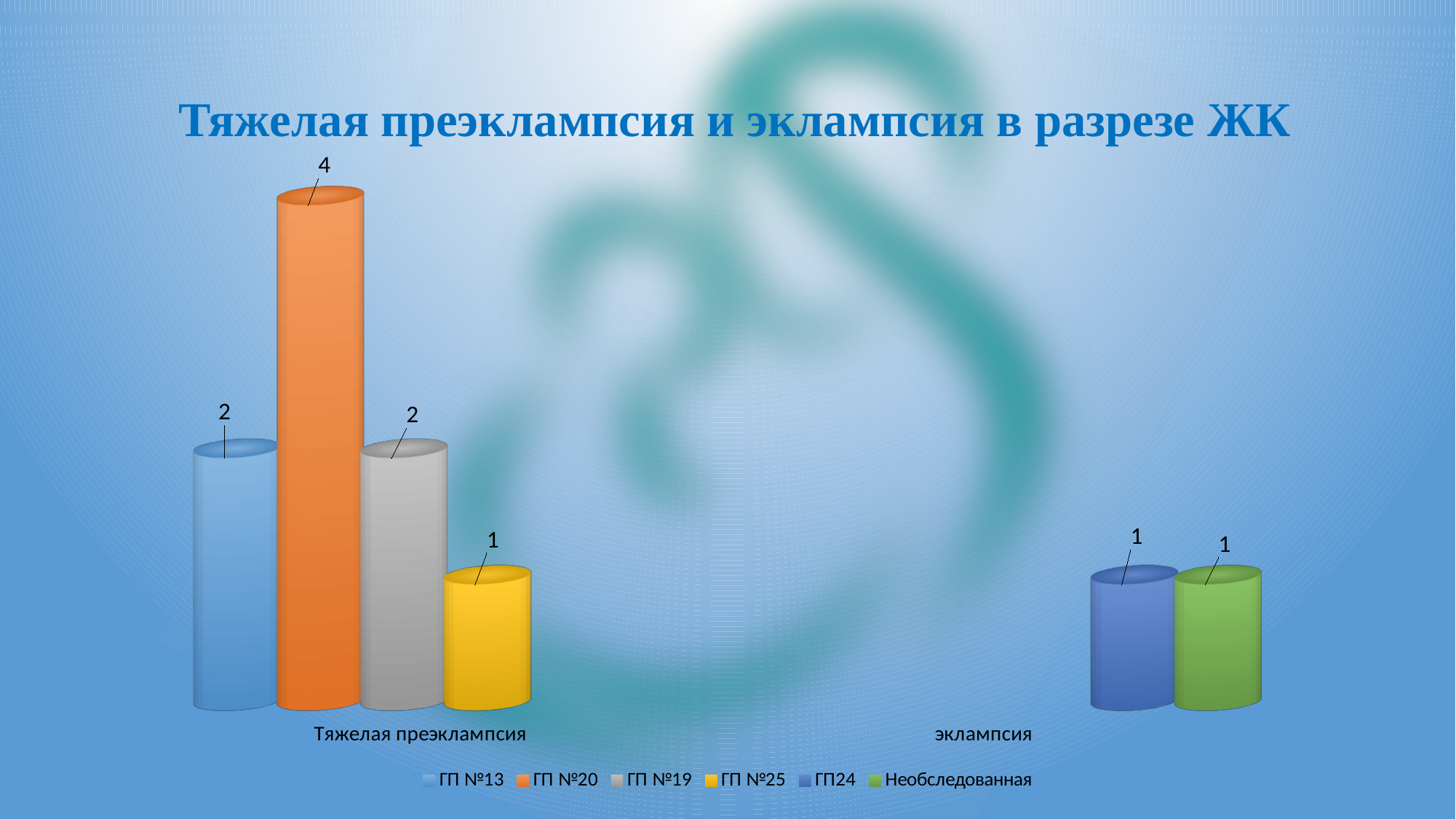
What is the value for ГП24 in the эклампсия category? 1 What kind of chart is shown on the slide? Bar chart What is the value for Необследованная in the эклампсия category? 1 What is the difference between the values for ГП №20 and ГП №19 in the Тяжелая преэклампсия category? 2 What is the value for ГП №25 in the Тяжелая преэклампсия category? 1 How many categories are shown on the x axis? 2 Which is larger in the Тяжелая преэклампсия category: ГП №20 or ГП №13? ГП №20 How many series does the legend list? 6 What is the value for ГП №20 in the Тяжелая преэклампсия category? 4 Which series has the highest value in the Тяжелая преэклампсия category? ГП №20 What is the value for ГП №13 in the Тяжелая преэклампсия category? 2 Which series has the lowest value in the Тяжелая преэклампсия category? ГП №25